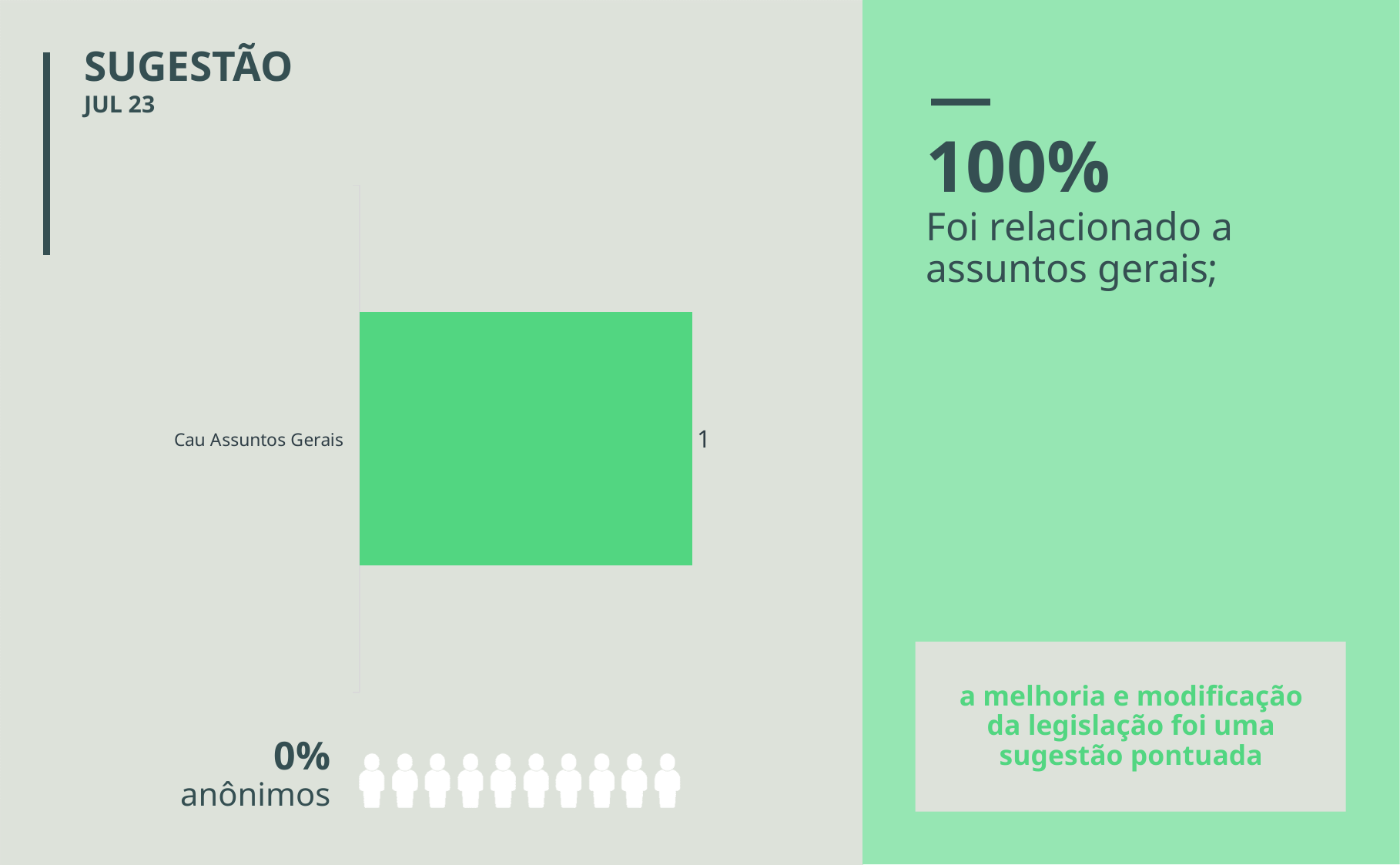
What is the value for Cau Assuntos Gerais in the bar chart? 1 Which category has the highest value in the bar chart? Cau Assuntos Gerais What kind of chart is shown on the slide? bar chart What colour is the bar in the chart? green What is the label of the only category in the bar chart? Cau Assuntos Gerais Is the value for Cau Assuntos Gerais greater or less than 0? greater How many categories does the bar chart show? 1